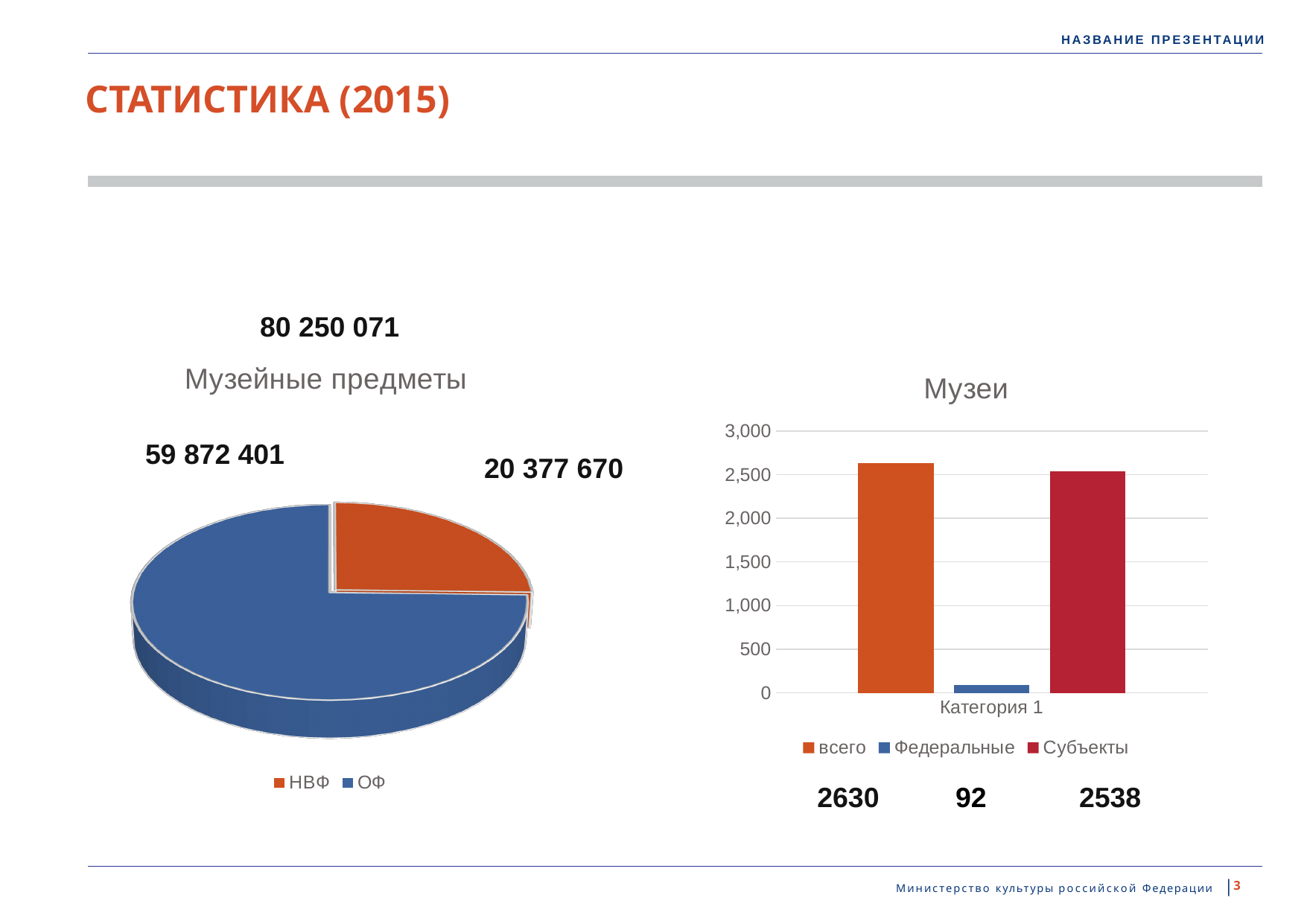
In the 'Музеи' chart, is the value for Субъекты greater or less than 2,000? greater What kind of chart is the 'Музеи' chart? bar chart In the 'Музеи' chart, what is the value for всего? 2630 In the 'Музейные предметы' chart, what is the value for НВФ? 20 377 670 In the 'Музеи' chart, which series has the highest value? всего In the 'Музеи' chart, which series has the lowest value? Федеральные In the 'Музеи' chart, how many series does the legend list? 3 In the 'Музеи' chart, what is the value for Субъекты? 2538 In the 'Музеи' chart, what is the difference between всего and Субъекты? 92 In the 'Музеи' chart, what is the value for Федеральные? 92 In the 'Музейные предметы' chart, which slice is larger, НВФ or ОФ? ОФ In the 'Музейные предметы' chart, what is the value for ОФ? 59 872 401